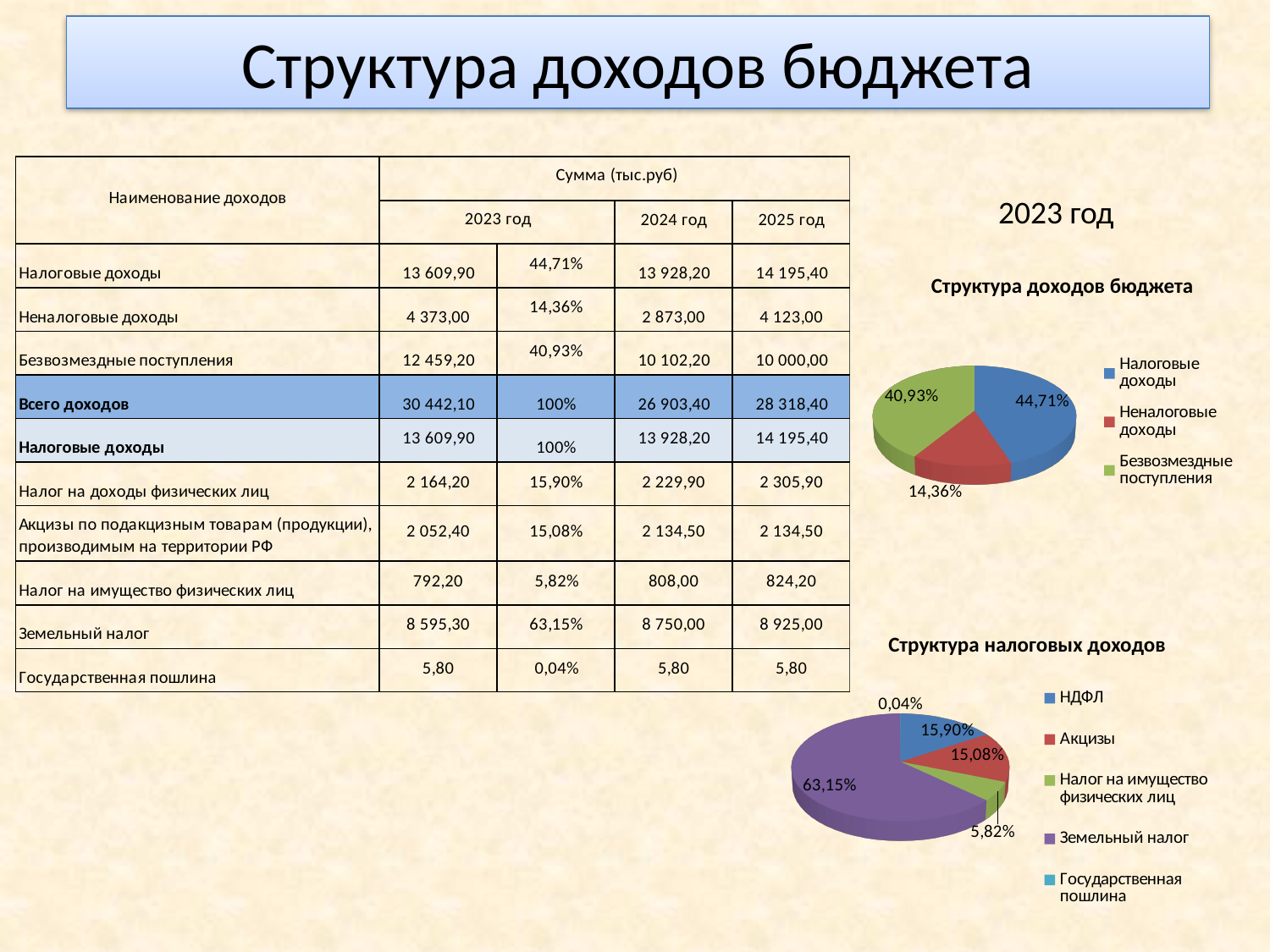
In the chart titled "Структура доходов бюджета", which category has the smallest slice? Неналоговые доходы In the chart titled "Структура налоговых доходов", what share is labelled for Земельный налог? 63,15% In the chart titled "Структура налоговых доходов", which category has the smallest slice? Государственная пошлина In the chart titled "Структура доходов бюджета", what share is labelled for Налоговые доходы? 44,71% In the chart titled "Структура налоговых доходов", what share is labelled for Государственная пошлина? 0,04% In the chart titled "Структура налоговых доходов", which category has the largest slice? Земельный налог What kind of chart is the one titled "Структура доходов бюджета"? Pie chart In the chart titled "Структура доходов бюджета", what share is labelled for Безвозмездные поступления? 40,93% In the chart titled "Структура налоговых доходов", how many categories does the legend list? 5 In the chart titled "Структура налоговых доходов", what is the difference in percentage points between НДФЛ and Налог на имущество физических лиц? 10,08 In the chart titled "Структура доходов бюджета", how many entries does the legend list? 3 Which year is shown above the chart titled "Структура доходов бюджета"? 2023 год